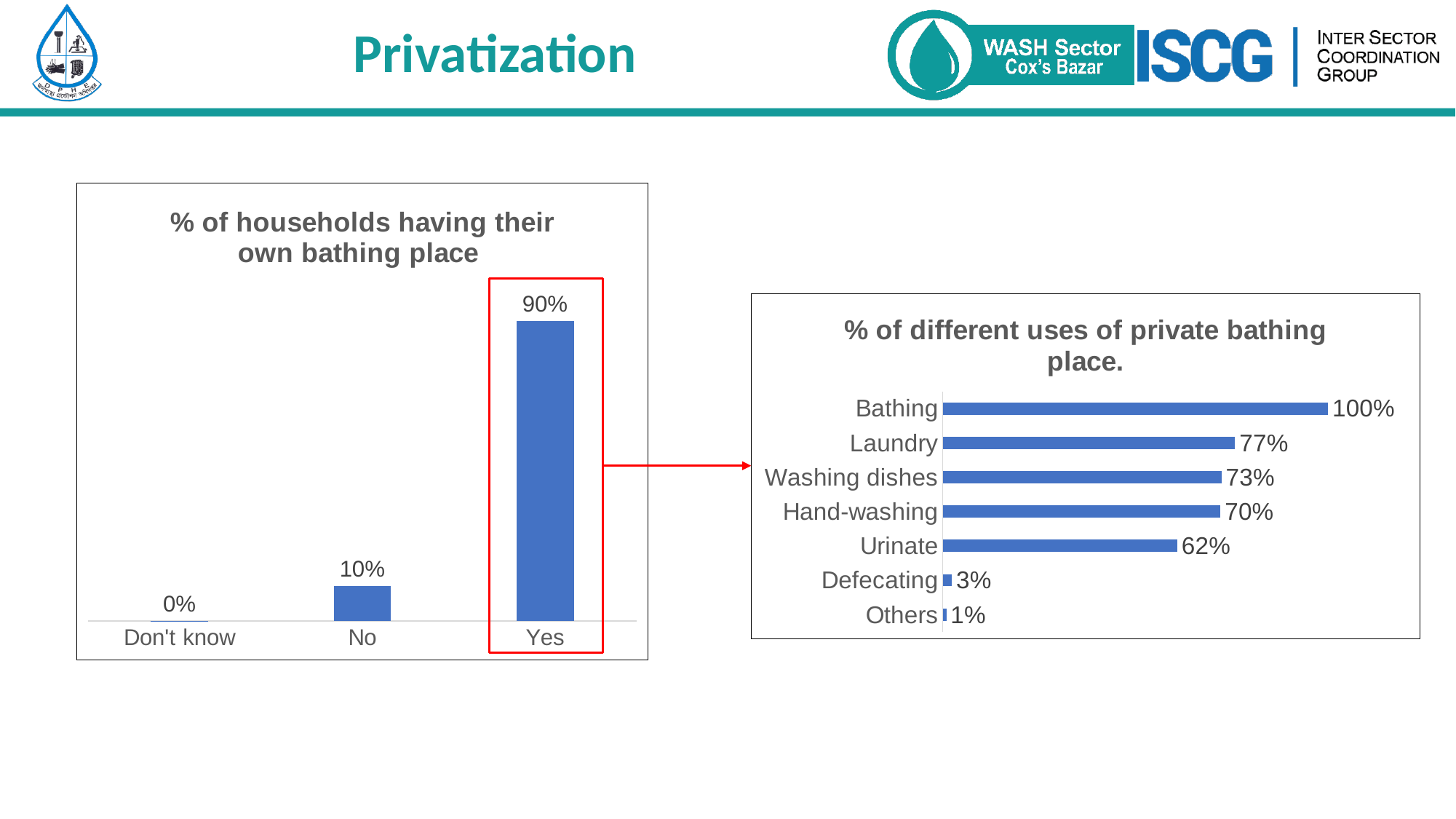
In the chart '% of households having their own bathing place', what is the difference between Yes and No? 80% In the chart '% of households having their own bathing place', what is the value for Yes? 90% In the chart '% of different uses of private bathing place.', what is the value for Laundry? 77% In the chart '% of different uses of private bathing place.', which category has the highest value? Bathing What kind of chart is '% of different uses of private bathing place.'? Bar chart In the chart '% of households having their own bathing place', what is the value for No? 10% In the chart '% of different uses of private bathing place.', what is the value for Urinate? 62% How many categories are shown in the chart '% of different uses of private bathing place.'? 7 In the chart '% of different uses of private bathing place.', what is the difference between Bathing and Defecating? 97% In the chart '% of different uses of private bathing place.', which is larger: Washing dishes or Hand-washing? Washing dishes In the chart '% of households having their own bathing place', which category has the lowest value? Don't know How many categories are shown in the chart '% of households having their own bathing place'? 3